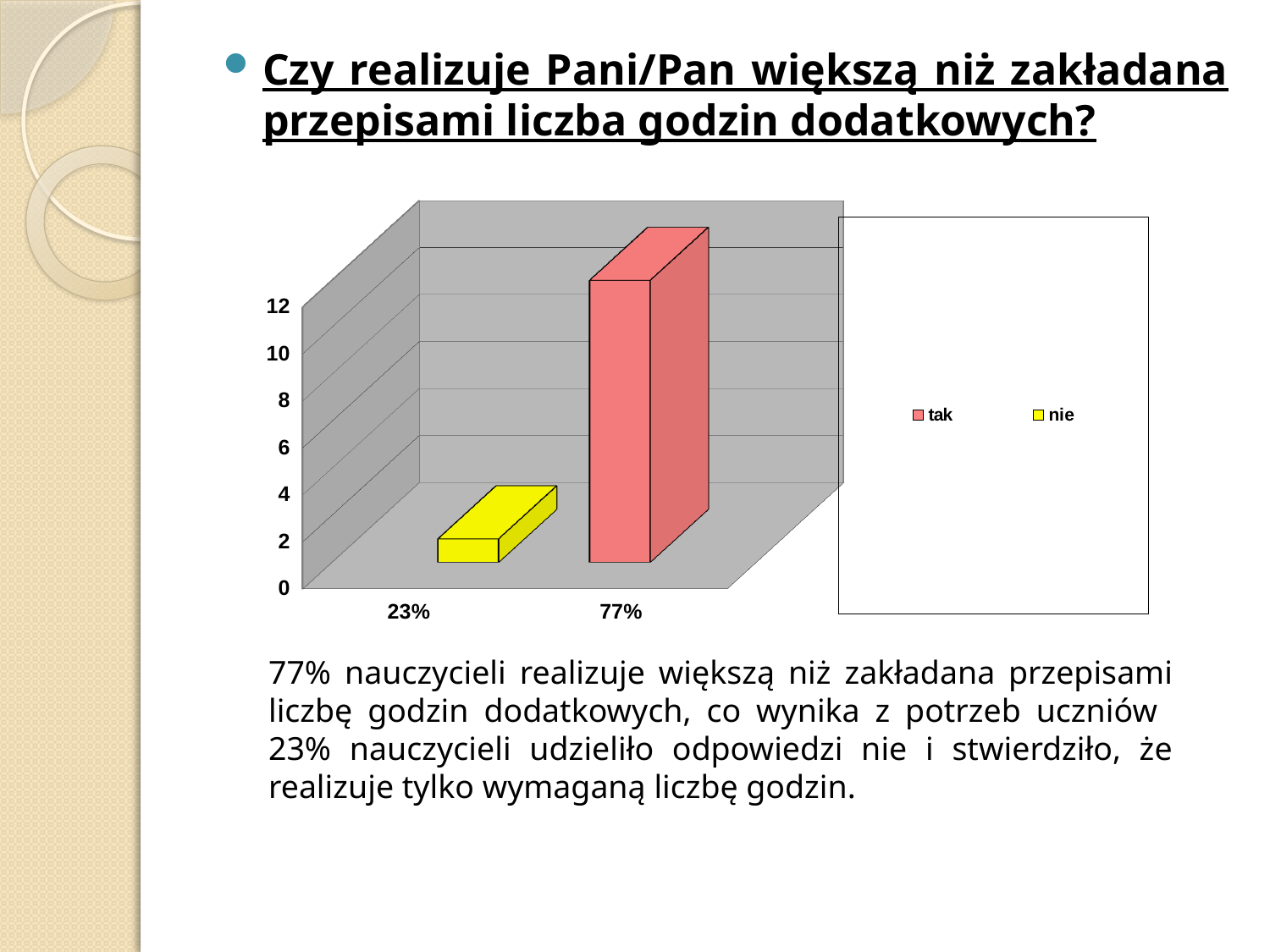
What percentage label is shown under the yellow 'nie' bar? 23% How many bars are plotted in the chart? 2 Which bar is taller, the one for 'tak' or the one for 'nie'? tak What percentage label is shown under the red 'tak' bar? 77% What colour is the bar for the 'nie' series? yellow Which series has the tallest bar in the chart? tak Is the value of the 'nie' bar greater or less than 4? less How many series does the chart legend list? 2 What is the highest value shown on the vertical axis of the chart? 12 Which series has the shortest bar in the chart? nie Is the value of the 'tak' bar greater or less than 8? greater What kind of chart is shown on the slide? bar chart